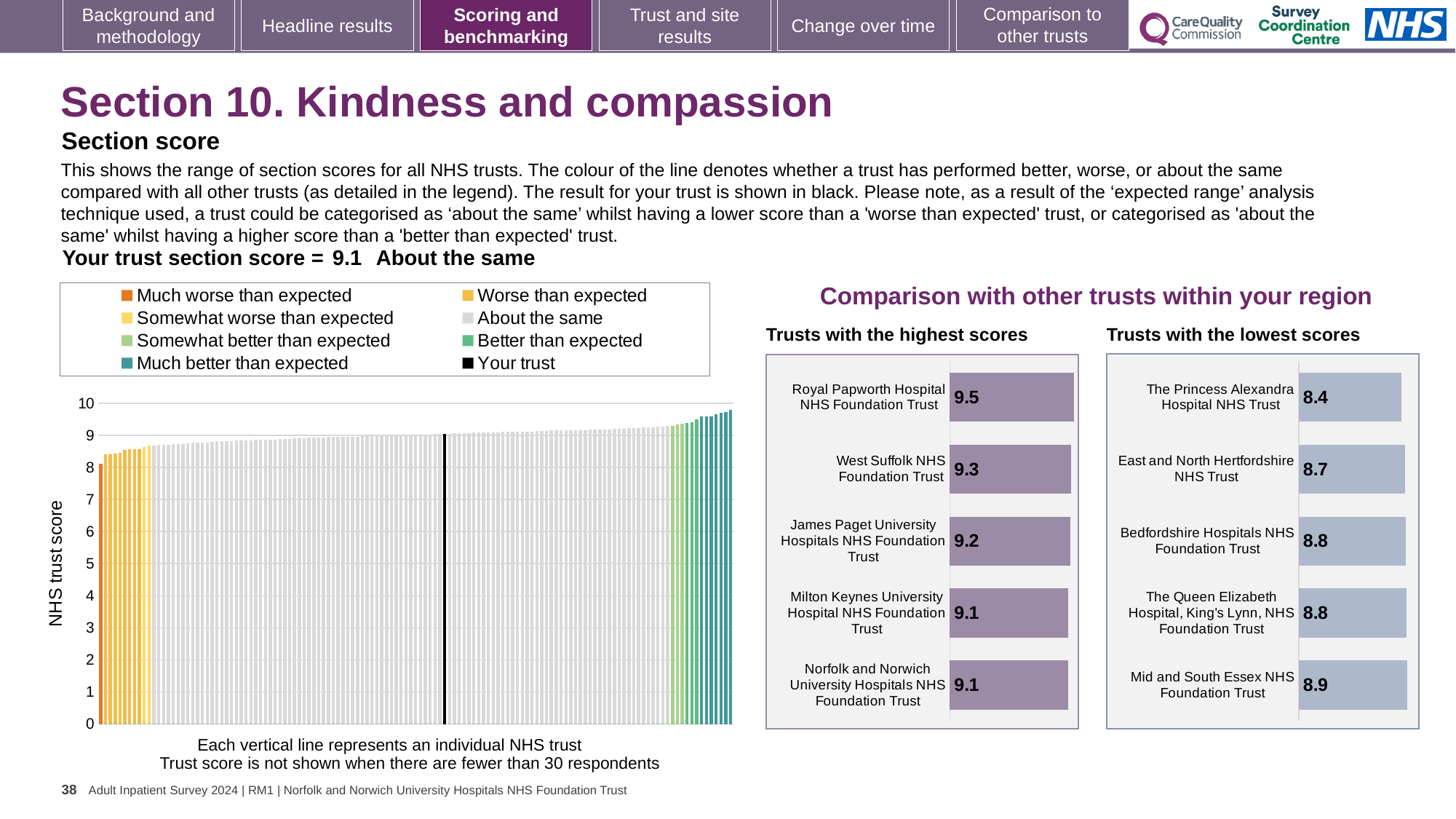
In the 'Trusts with the lowest scores' chart, what is the difference between the scores of Mid and South Essex NHS Foundation Trust and The Princess Alexandra Hospital NHS Trust? 0.5 In the 'Trusts with the highest scores' chart, what is the score for James Paget University Hospitals NHS Foundation Trust? 9.2 How many trusts are shown in the 'Trusts with the highest scores' chart? 5 In the 'Trusts with the lowest scores' chart, what is the score for The Princess Alexandra Hospital NHS Trust? 8.4 In the 'Trusts with the lowest scores' chart, which trust has the highest score? Mid and South Essex NHS Foundation Trust In the 'Trusts with the lowest scores' chart, which trust has the lowest score? The Princess Alexandra Hospital NHS Trust In the 'Trusts with the highest scores' chart, what is the score for Royal Papworth Hospital NHS Foundation Trust? 9.5 In the 'Trusts with the highest scores' chart, which trust has the highest score? Royal Papworth Hospital NHS Foundation Trust In the main chart on the left showing NHS trust scores, do the values rise or fall from left to right? rise In the 'Trusts with the lowest scores' chart, which has the larger score: East and North Hertfordshire NHS Trust or Bedfordshire Hospitals NHS Foundation Trust? Bedfordshire Hospitals NHS Foundation Trust In the 'Trusts with the highest scores' chart, what is the difference between the scores of Royal Papworth Hospital NHS Foundation Trust and West Suffolk NHS Foundation Trust? 0.2 How many entries does the legend of the main chart on the left list? 8